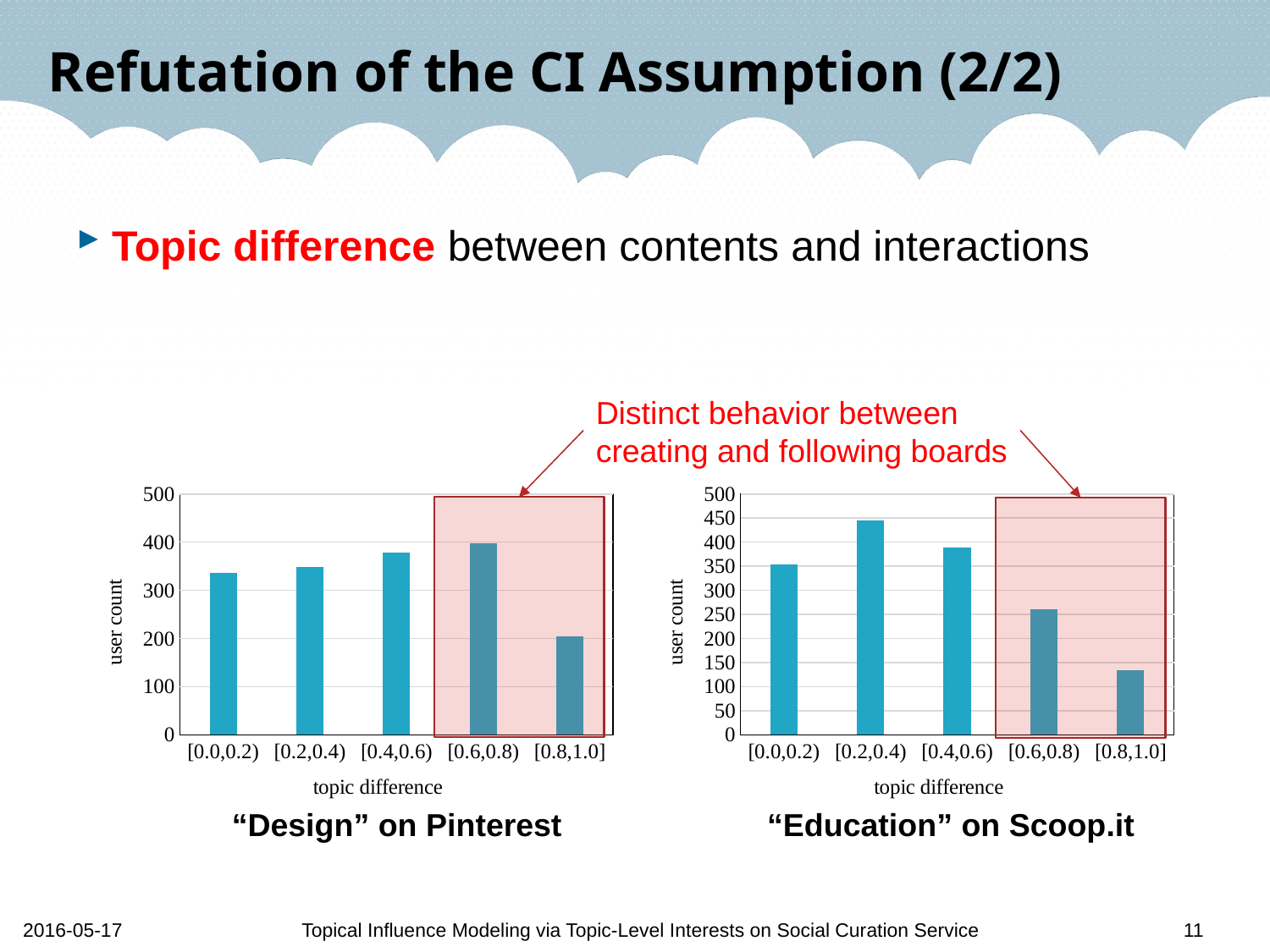
In the "Design" on Pinterest chart, is the user count for [0.0,0.2) greater or less than 300? greater In the "Education" on Scoop.it chart, do the user counts rise or fall from [0.2,0.4) to [0.8,1.0]? fall In the "Education" on Scoop.it chart, which topic difference bin has the lowest user count? [0.8,1.0] In the "Design" on Pinterest chart, which topic difference bin has the highest user count? [0.6,0.8) In the "Design" on Pinterest chart, is the user count for [0.8,1.0] greater or less than 300? less In the "Design" on Pinterest chart, which topic difference bin has the lowest user count? [0.8,1.0] In the "Design" on Pinterest chart, how many topic difference bins are plotted? 5 In the "Design" on Pinterest chart, what kind of chart is shown? bar chart In the "Education" on Scoop.it chart, which has a larger user count, [0.0,0.2) or [0.8,1.0]? [0.0,0.2) In the "Education" on Scoop.it chart, what is the label of the y axis? user count In the "Education" on Scoop.it chart, which topic difference bin has the highest user count? [0.2,0.4) In the "Education" on Scoop.it chart, is the user count for [0.6,0.8) greater or less than 300? less